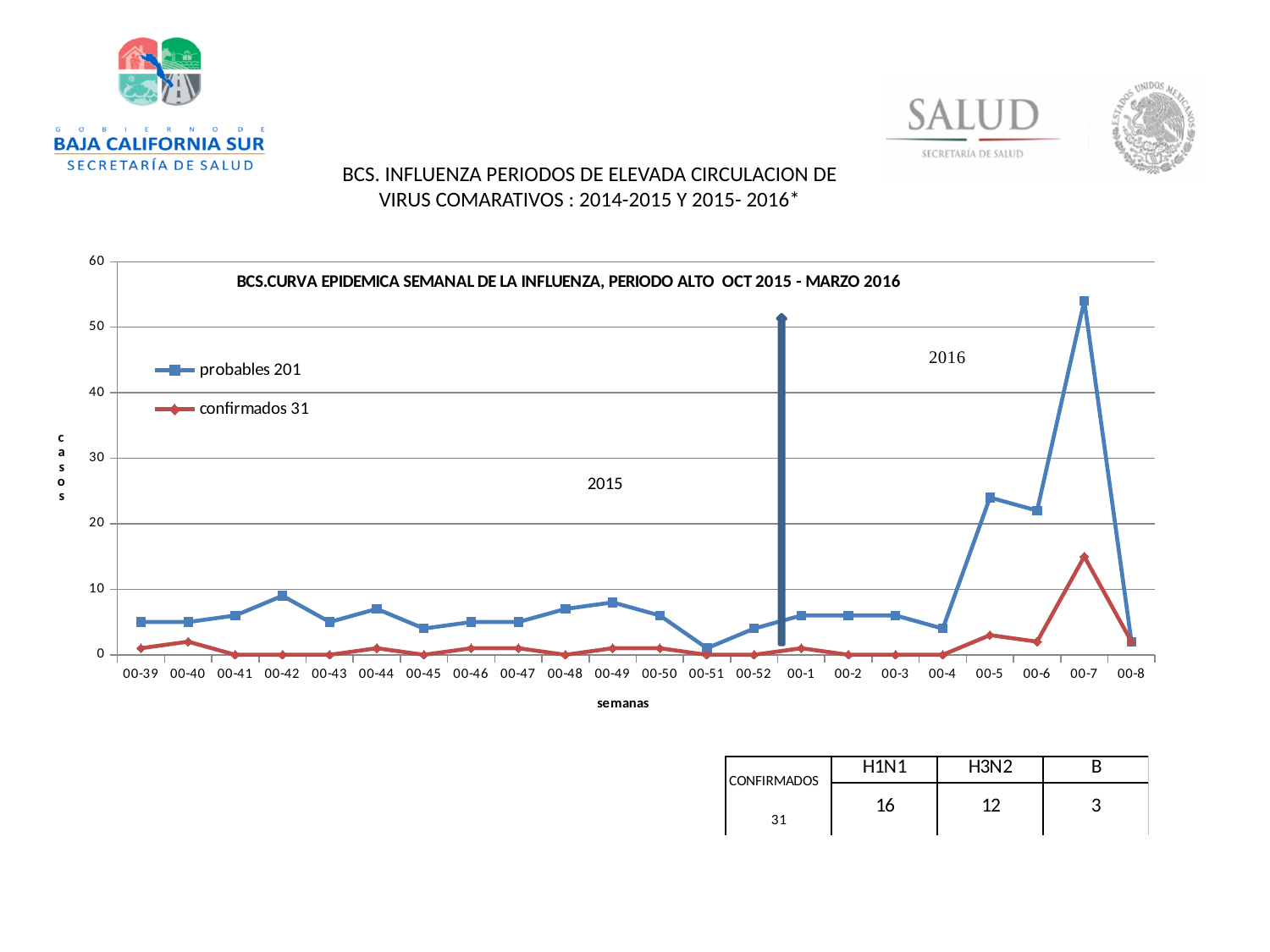
What kind of chart is shown on the slide? line chart Is the value of 'probables 201' in week 00-5 greater or less than 20? greater In which week does the 'probables 201' series reach its highest value? 00-7 In which week does the 'confirmados 31' series reach its highest value? 00-7 Which is larger for 'probables 201': the value in week 00-42 or in week 00-43? 00-42 Is the value of 'confirmados 31' in week 00-7 greater or less than 10? greater What label is shown on the x axis of the chart? semanas How many weeks (categories) are plotted along the x axis? 22 Is the value of 'probables 201' in week 00-7 greater or less than 50? greater How many series does the chart legend list? 2 Does the 'probables 201' series rise or fall from week 00-4 to week 00-7? rise